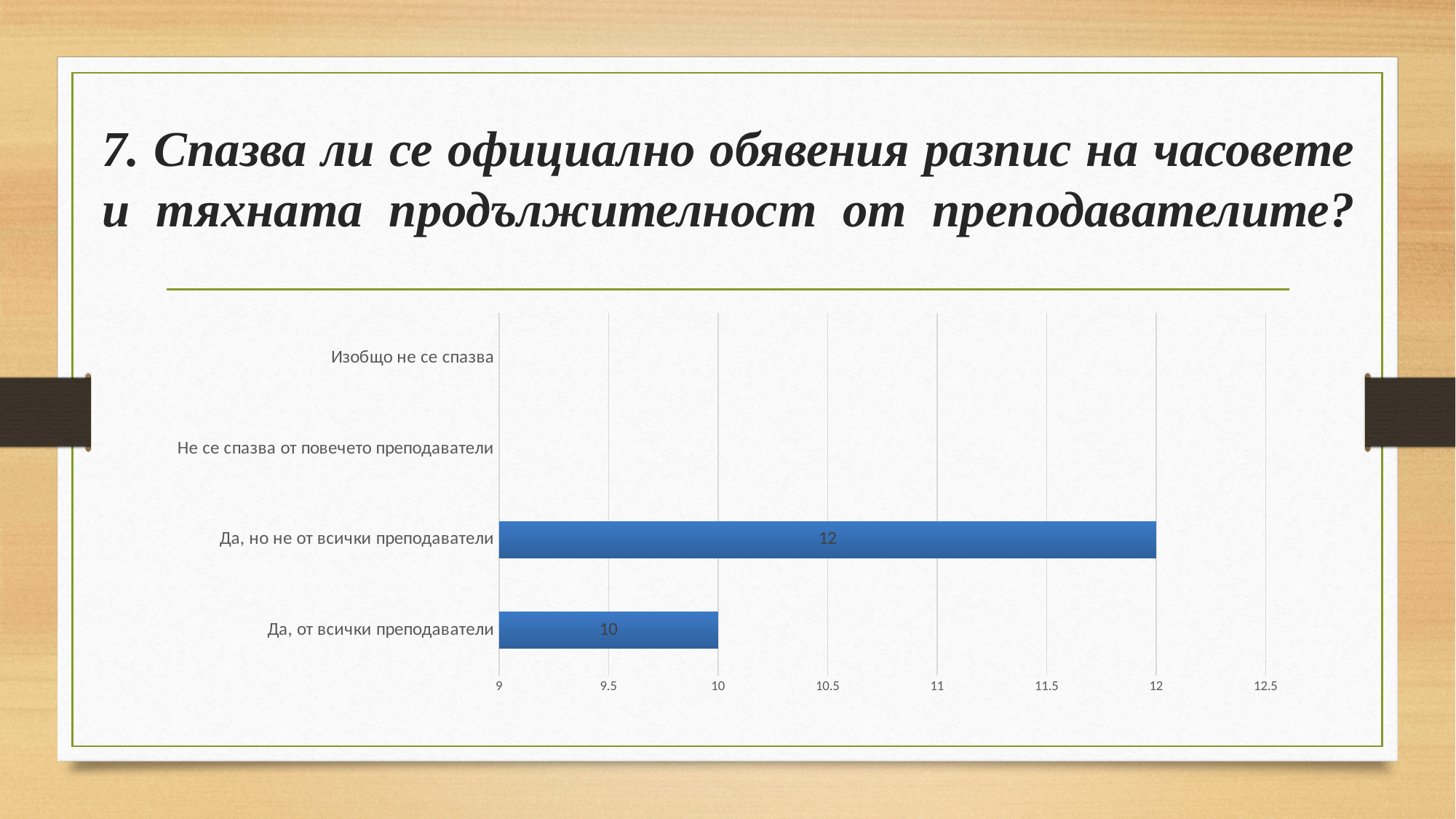
Is the value for "Да, от всички преподаватели" greater or less than 11? less Is the value for "Да, но не от всички преподаватели" greater or less than 11? greater Which category has the highest value? Да, но не от всички преподаватели How many categories on the chart have a visible bar? 2 What is the value for "Да, от всички преподаватели"? 10 How many categories are listed on the chart's vertical axis? 4 What kind of chart is shown on the slide? bar chart Which is larger: the value for "Да, от всички преподаватели" or the value for "Да, но не от всички преподаватели"? Да, но не от всички преподаватели What is the highest tick value shown on the horizontal axis? 12.5 What colour are the bars in the chart? blue What is the difference between the values for "Да, но не от всички преподаватели" and "Да, от всички преподаватели"? 2 What is the value for "Да, но не от всички преподаватели"? 12